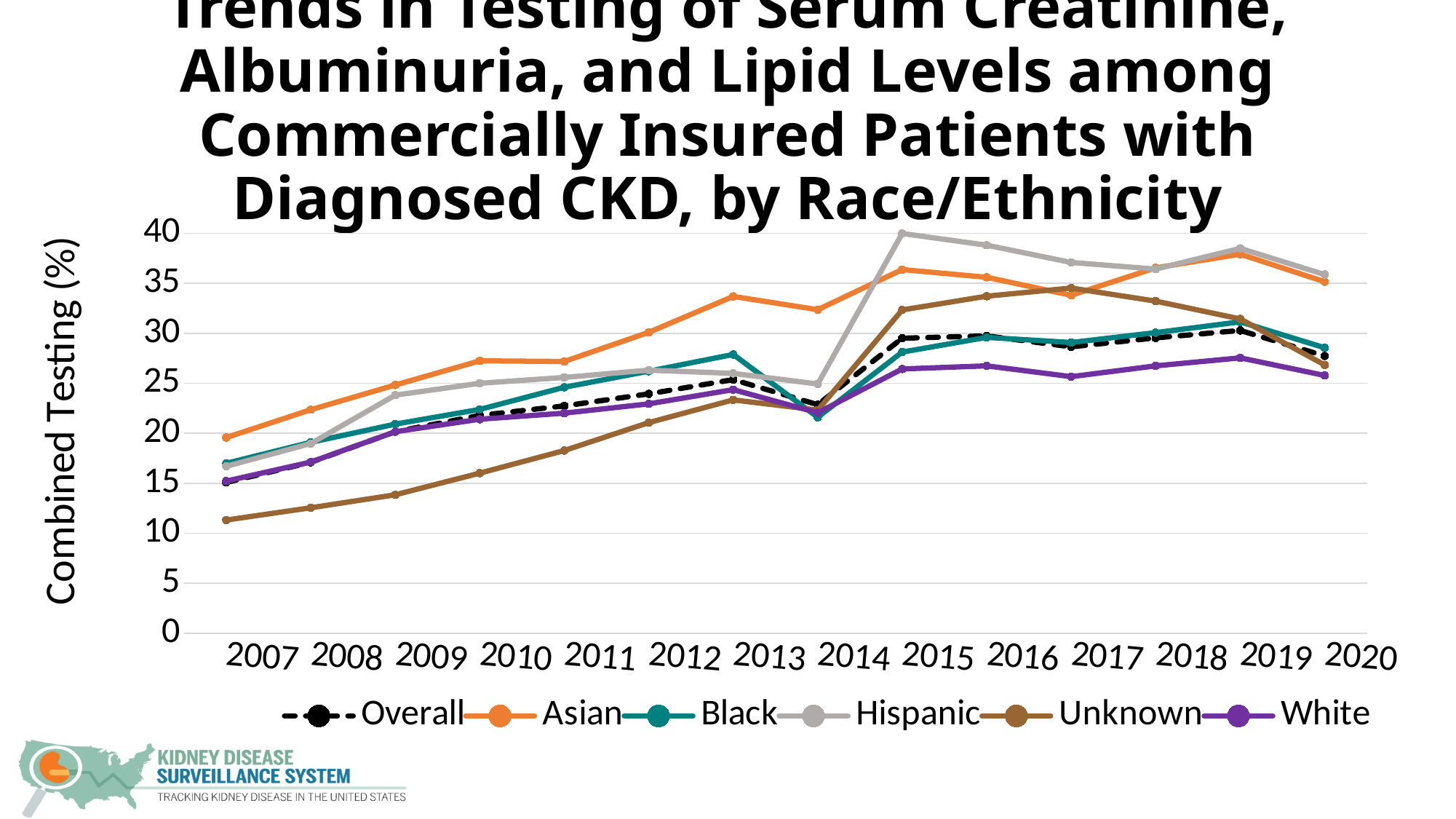
How many series does the legend list? 6 What kind of chart is shown on the slide? line chart Does the Unknown series rise or fall from 2007 to 2017? rise Is the value for Hispanic in 2015 greater or less than 35? greater Which series has the lowest value in 2007? Unknown Which series has the highest value in 2007? Asian Which series has the highest value in 2015? Hispanic Is the value for Unknown in 2007 greater or less than 15? less Which is larger in 2012, the value for Asian or the value for White? Asian How many years are shown along the x axis? 14 Which series has the lowest value in 2010? Unknown